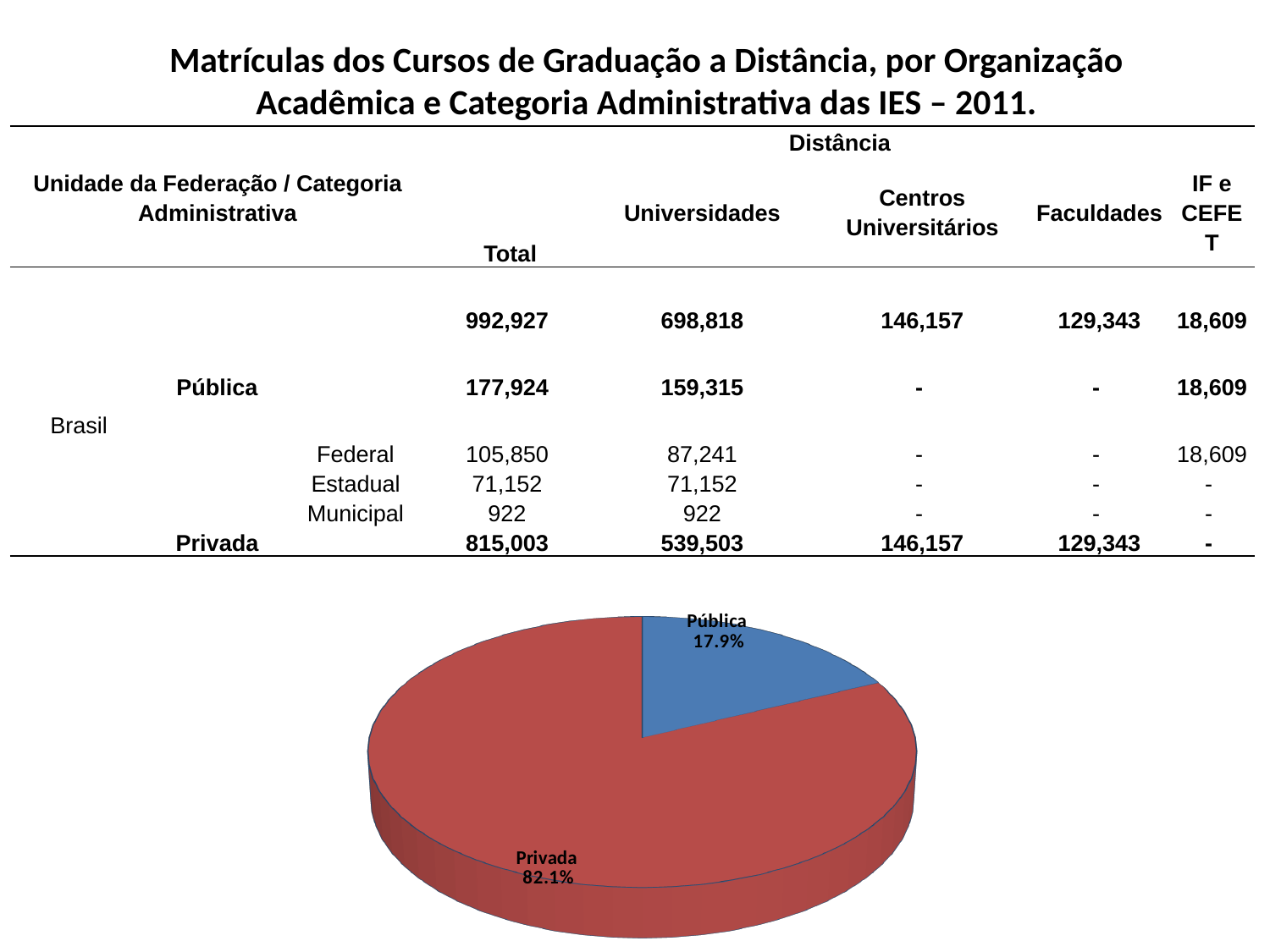
How many slices does the pie chart have? 2 What colour is the Privada slice in the pie chart? red What kind of chart is shown on the slide? pie chart What is the difference in percentage points between the Privada and Pública slices of the pie chart? 64.2 Which slice of the pie chart is the smallest? Pública What share of the pie chart does the Pública slice represent? 17.9% Which slice of the pie chart is the largest? Privada In the pie chart, which is larger, Pública or Privada? Privada What colour is the Pública slice in the pie chart? blue What share of the pie chart does the Privada slice represent? 82.1%